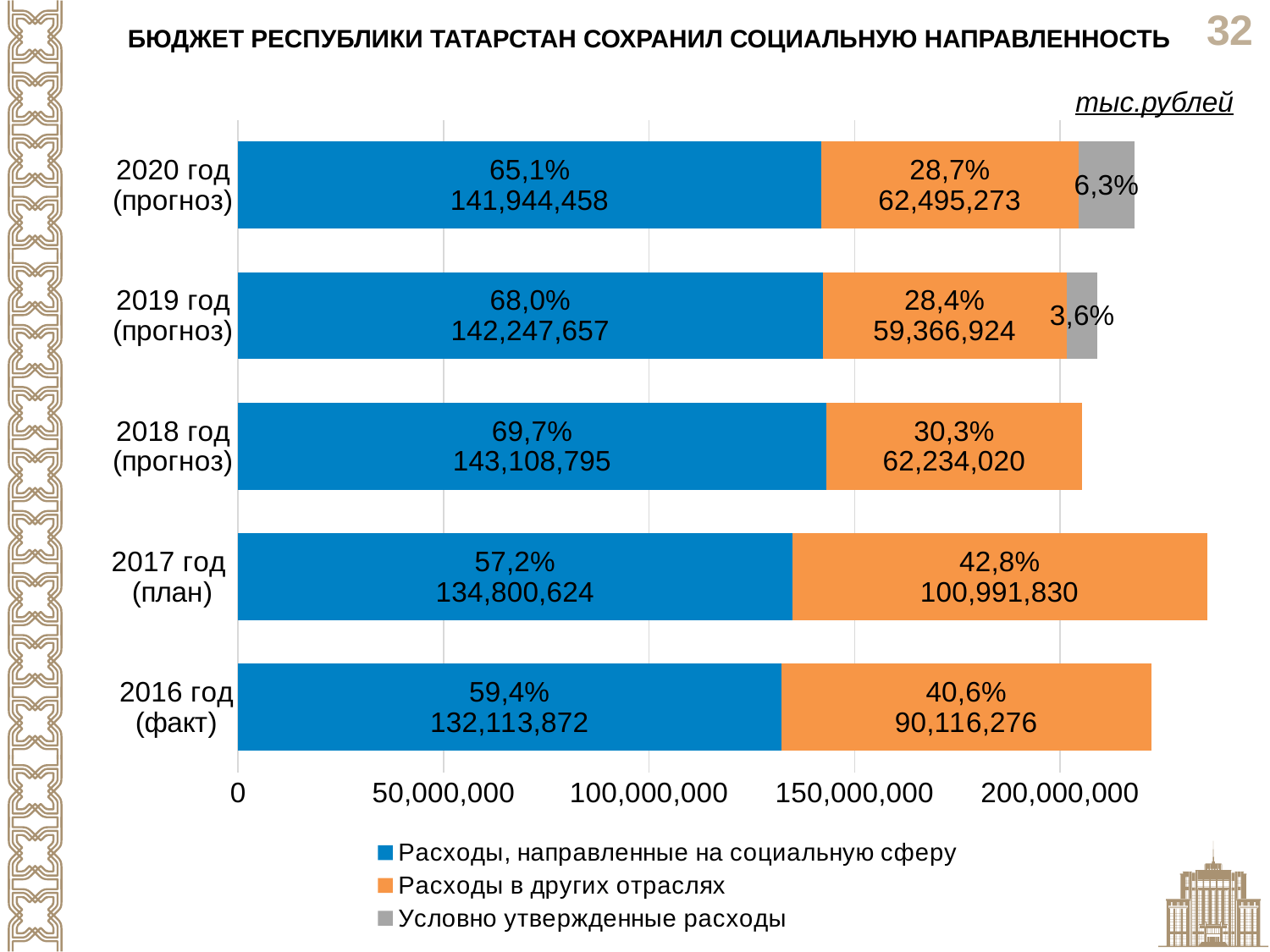
Which is larger: expenditures in other sectors in 2020 год (прогноз) or in 2018 год (прогноз)? 2020 год (прогноз) What is the total of the 2016 год (факт) bar (social sphere plus other sectors)? 222,230,148 What type of chart is shown on the slide? Stacked bar chart What percentage is shown for conditionally approved expenditures (Условно утвержденные расходы) in 2020 год (прогноз)? 6,3% How many series does the legend list? 3 What is the value of expenditures directed to the social sphere (Расходы, направленные на социальную сферу) for 2016 год (факт)? 132,113,872 Which year has the lowest value of social-sphere expenditures? 2016 год (факт) What percentage share do social-sphere expenditures make up in 2018 год (прогноз)? 69,7% How many years (categories) are shown on the chart? 5 What is the value of expenditures in other sectors (Расходы в других отраслях) for 2017 год (план)? 100,991,830 What is the difference between expenditures in other sectors in 2017 год (план) and in 2016 год (факт)? 10,875,554 Which year has the highest value of expenditures in other sectors? 2017 год (план)